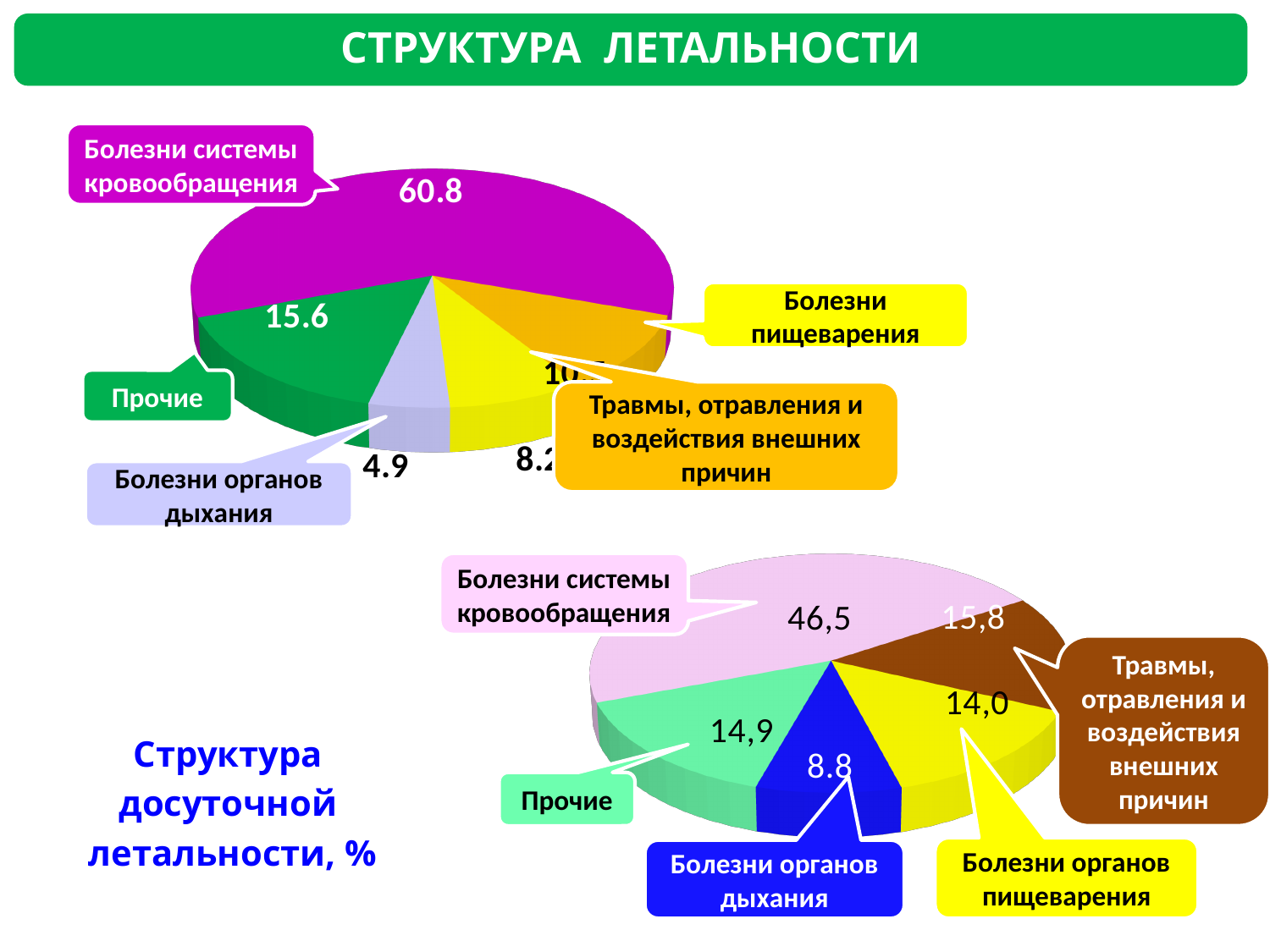
In the bottom chart (Структура досуточной летальности, %), what is the value for Болезни системы кровообращения? 46,5 In the top chart (Структура летальности), which category has the largest slice? Болезни системы кровообращения In the top chart (Структура летальности), what is the value for Болезни системы кровообращения? 60.8 In the bottom chart (Структура досуточной летальности, %), how many slices does the pie have? 5 In the bottom chart (Структура досуточной летальности, %), which is larger: Прочие or Болезни органов пищеварения? Прочие In the top chart (Структура летальности), what is the value for Болезни органов дыхания? 4.9 In the bottom chart (Структура досуточной летальности, %), what is the value for Травмы, отравления и воздействия внешних причин? 15,8 In the bottom chart (Структура досуточной летальности, %), what is the value for Болезни органов дыхания? 8.8 In the bottom chart (Структура досуточной летальности, %), which category has the smallest slice? Болезни органов дыхания In the top chart (Структура летальности), what is the value for Прочие? 15.6 What type of chart is the bottom chart (Структура досуточной летальности, %)? Pie chart In the top chart (Структура летальности), what is the difference between Болезни системы кровообращения and Прочие? 45.2